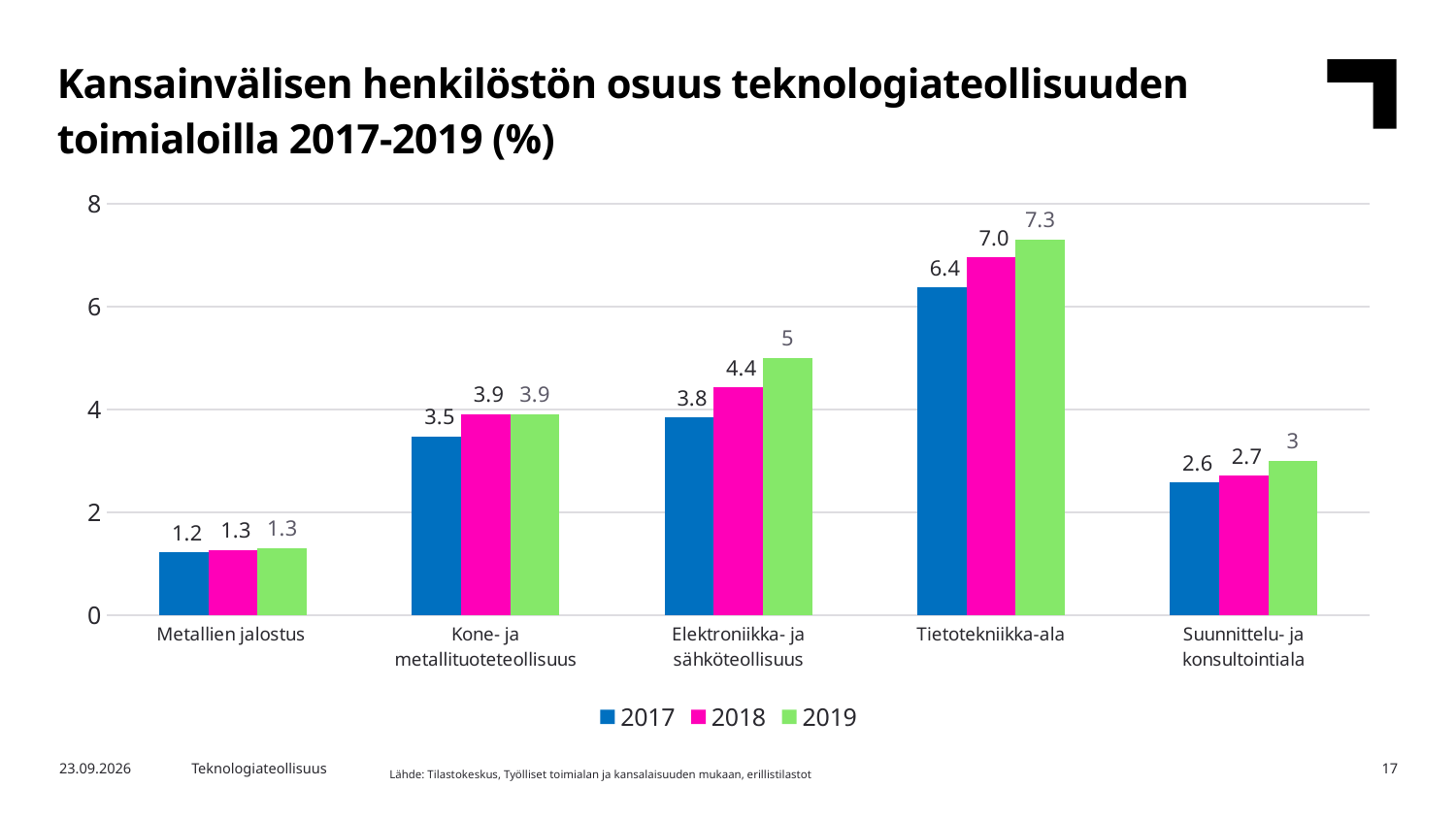
What is the difference between the 2019 and 2017 values for Elektroniikka- ja sähköteollisuus? 1.2 Is the 2017 value for Tietotekniikka-ala greater or less than 6? greater Which category has the highest value in 2018? Tietotekniikka-ala Which colour represents the 2018 series? magenta (pink) What is the value for Tietotekniikka-ala in 2019? 7.3 How many categories are shown on the x axis? 5 Which category has the lowest value in 2019? Metallien jalostus What kind of chart is shown on the slide? bar chart How many series does the legend list? 3 What is the value for Elektroniikka- ja sähköteollisuus in 2018? 4.4 Which is larger: the 2019 value for Kone- ja metallituoteteollisuus or the 2019 value for Suunnittelu- ja konsultointiala? Kone- ja metallituoteteollisuus What is the value for Metallien jalostus in 2017? 1.2